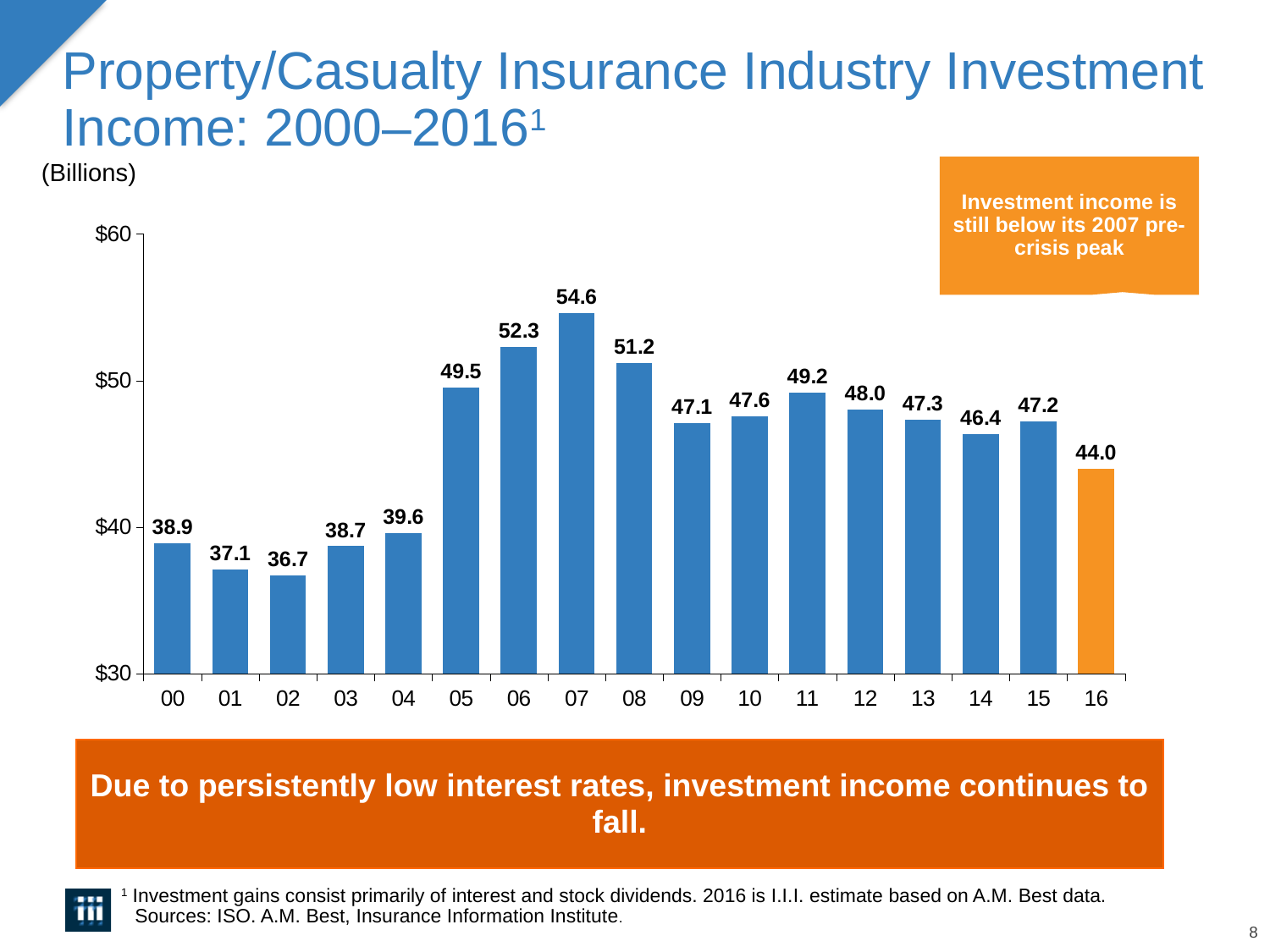
How many years are plotted on the chart? 17 What is the difference between the 2007 value and the 2016 value? 10.6 Which bar is shown in a different colour (orange) from the others? 16 Which year has the highest investment income? 07 What is the difference between the 2000 value and the 2002 value? 2.2 Do the values rise or fall from 2011 to 2016? fall What is the investment income value for 2016? 44.0 What is the investment income value for 2007? 54.6 Which is larger, the value for 2011 or the value for 2012? 2011 Which year has the lowest investment income? 02 What kind of chart is shown on the slide? bar chart Is the value for 2005 greater or less than $40? greater